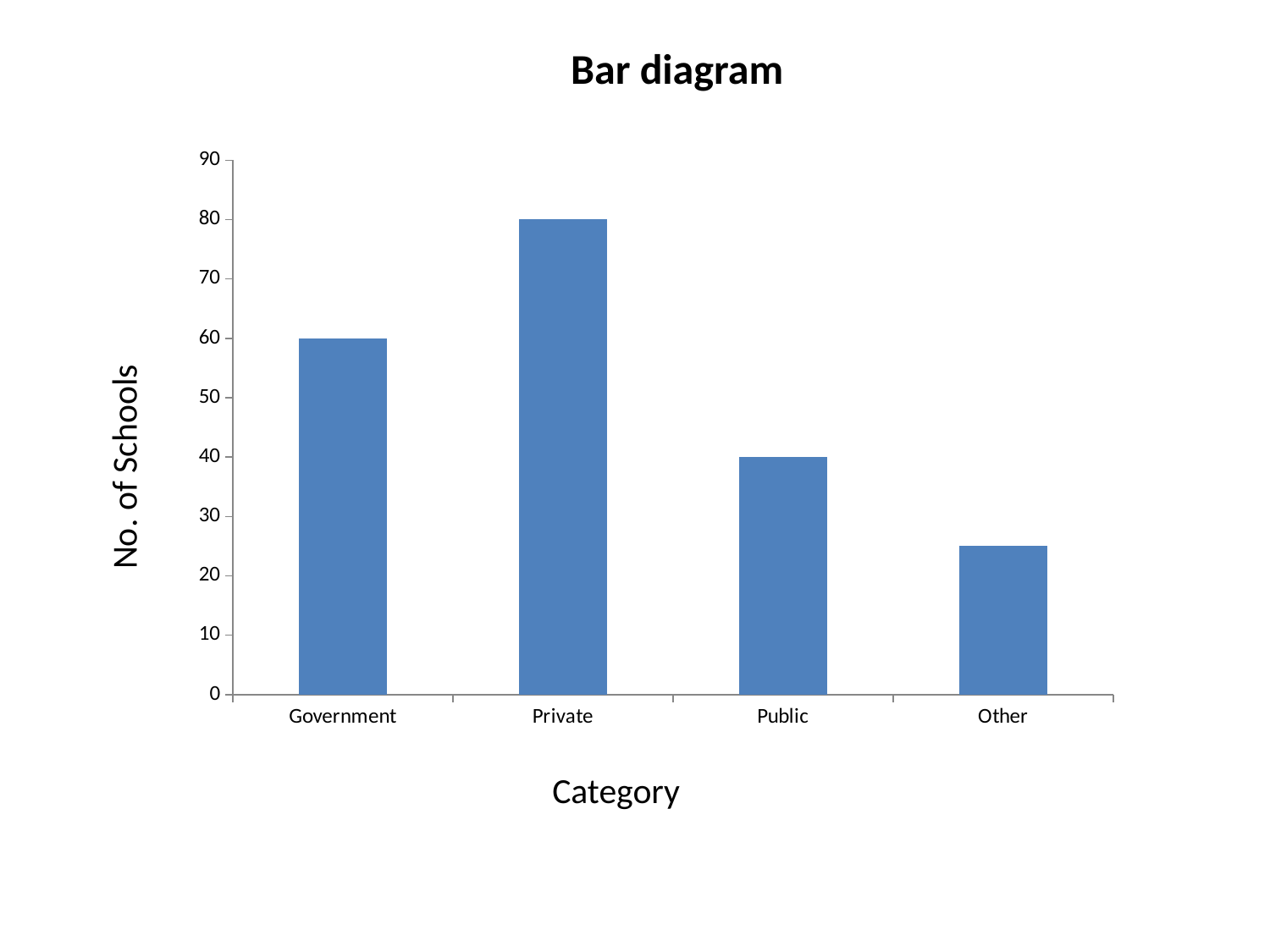
Is the value for Other greater or less than 30? less Which category has the lowest number of schools? Other What is the value for Private? 80 What kind of chart is shown on the slide? bar chart What is the difference between the values for Private and Government? 20 Which category has the highest number of schools? Private What is the value for Public? 40 How many categories are shown on the x axis? 4 What is the value for Government? 60 What is the difference between the values for Private and Public? 40 Which is larger, the value for Government or the value for Public? Government What is the label of the y axis? No. of Schools